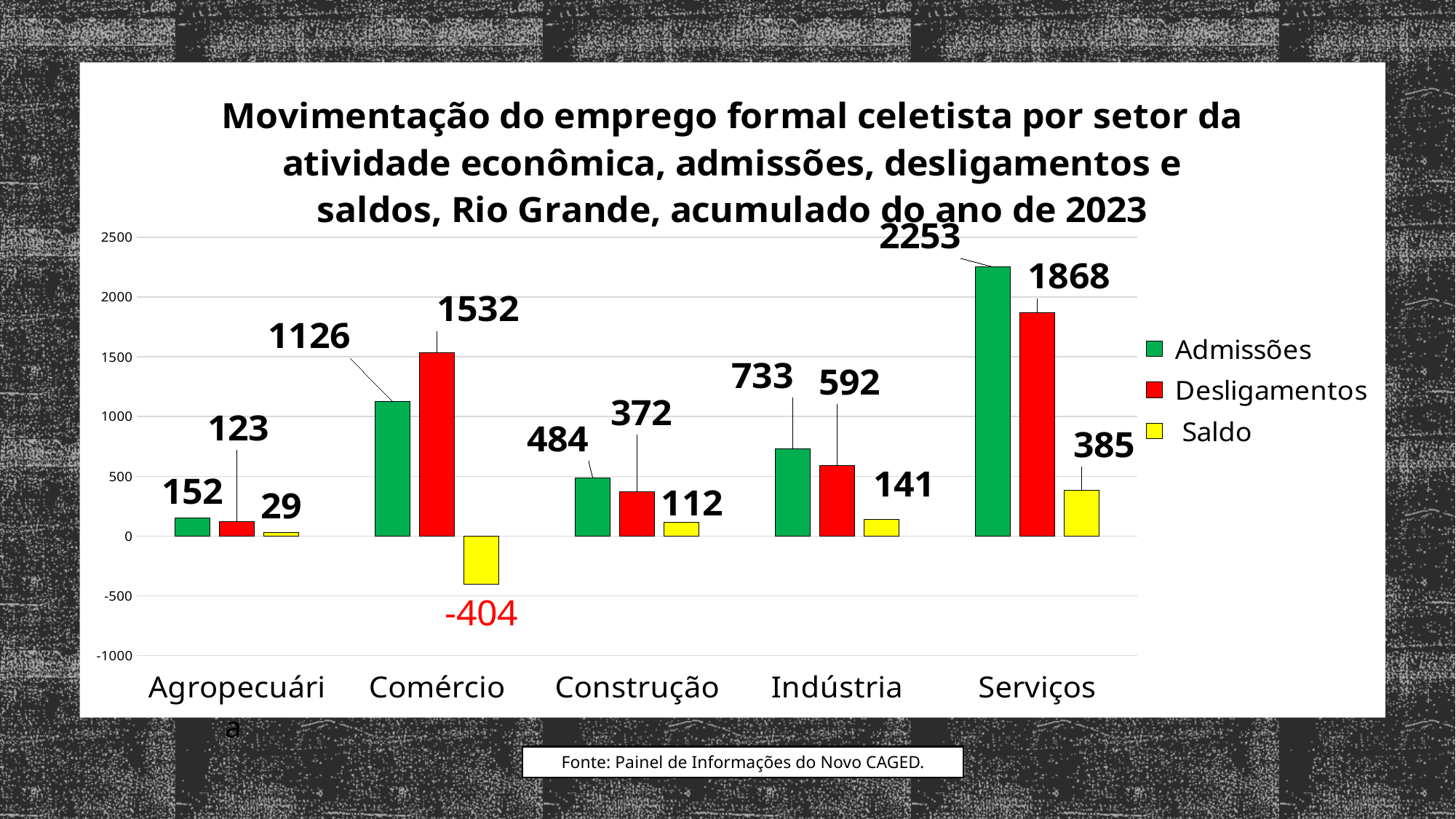
What kind of chart is shown on the slide? Bar chart What is the value of Admissões for Comércio? 1126 What colour represents the Saldo series? Yellow Which is larger for Comércio, Admissões or Desligamentos? Desligamentos What is the value of Desligamentos for Serviços? 1868 Which sector has the lowest Saldo value? Comércio How many sectors are shown on the x axis? 5 How many series does the legend list? 3 What is the Saldo value for Indústria? 141 Which sector has the highest Admissões value? Serviços What is the difference between Admissões and Desligamentos for Construção? 112 What is the Saldo value for Comércio? -404